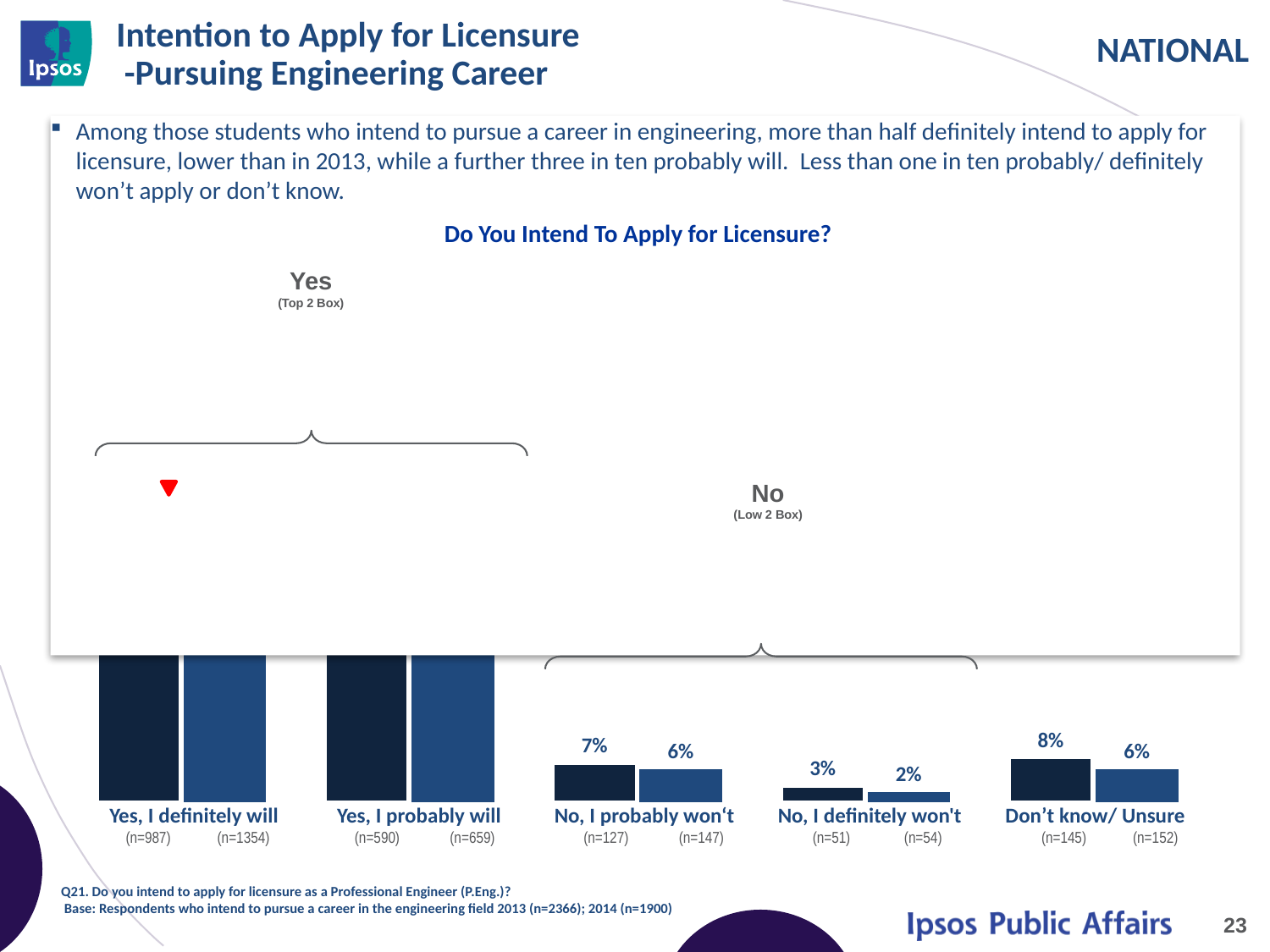
Which response category has the tallest bars in the chart? Yes, I definitely will What is the value of the lighter blue bar for "No, I probably won't"? 6% What is the value of the lighter blue bar for "No, I definitely won't"? 2% What is the value of the dark navy bar for "Don't know/ Unsure"? 8% What kind of chart is shown under the heading "Do You Intend To Apply for Licensure?"? Bar chart What is the difference between the dark navy bar and the lighter blue bar for "Don't know/ Unsure"? 2 percentage points What is the value of the dark navy bar for "No, I probably won't"? 7% Which response category has the lowest values in the chart? No, I definitely won't What is the difference between the dark navy bar and the lighter blue bar for "No, I definitely won't"? 1 percentage point Which two response categories are grouped under the "No (Low 2 Box)" bracket? No, I probably won't; No, I definitely won't How many response categories are shown along the bottom of the chart? 5 Which is larger: the dark navy bar for "No, I probably won't" or the dark navy bar for "Don't know/ Unsure"? Don't know/ Unsure